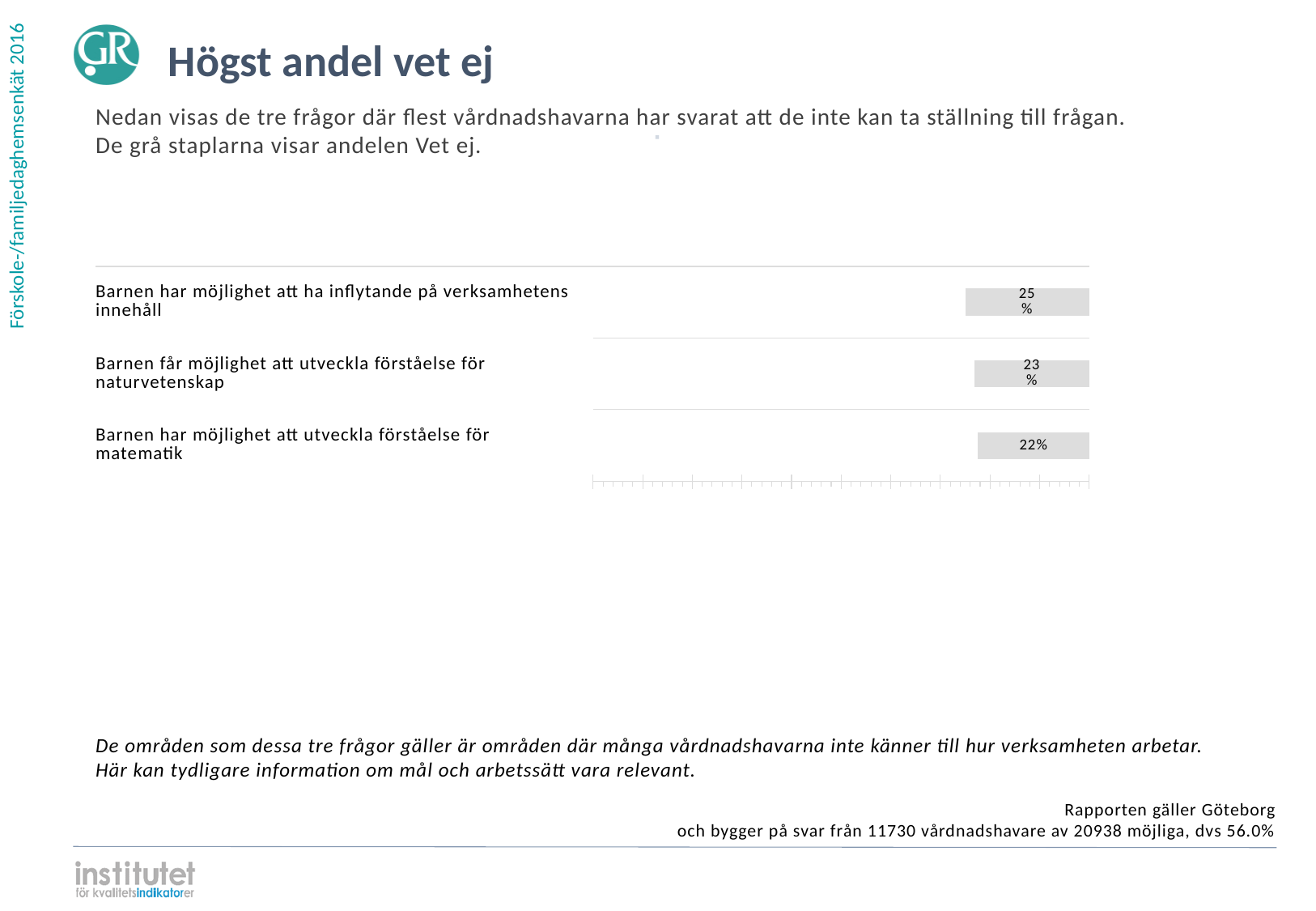
How many questions are shown in the chart? 3 What is the difference in Vet ej share between the naturvetenskap question and the matematik question? 1% What is the title of the slide? Högst andel vet ej What is the Vet ej share for "Barnen får möjlighet att utveckla förståelse för naturvetenskap"? 23% Which has a larger Vet ej share: the naturvetenskap question or the inflytande question? The inflytande question Which question has the lowest share of Vet ej? Barnen har möjlighet att utveckla förståelse för matematik What is the difference in Vet ej share between the inflytande question and the matematik question? 3% Which question has the highest share of Vet ej? Barnen har möjlighet att ha inflytande på verksamhetens innehåll What colour are the bars in the chart? Grey What is the Vet ej share for "Barnen har möjlighet att ha inflytande på verksamhetens innehåll"? 25% What is the Vet ej share for "Barnen har möjlighet att utveckla förståelse för matematik"? 22% What kind of chart is shown on the slide? Bar chart